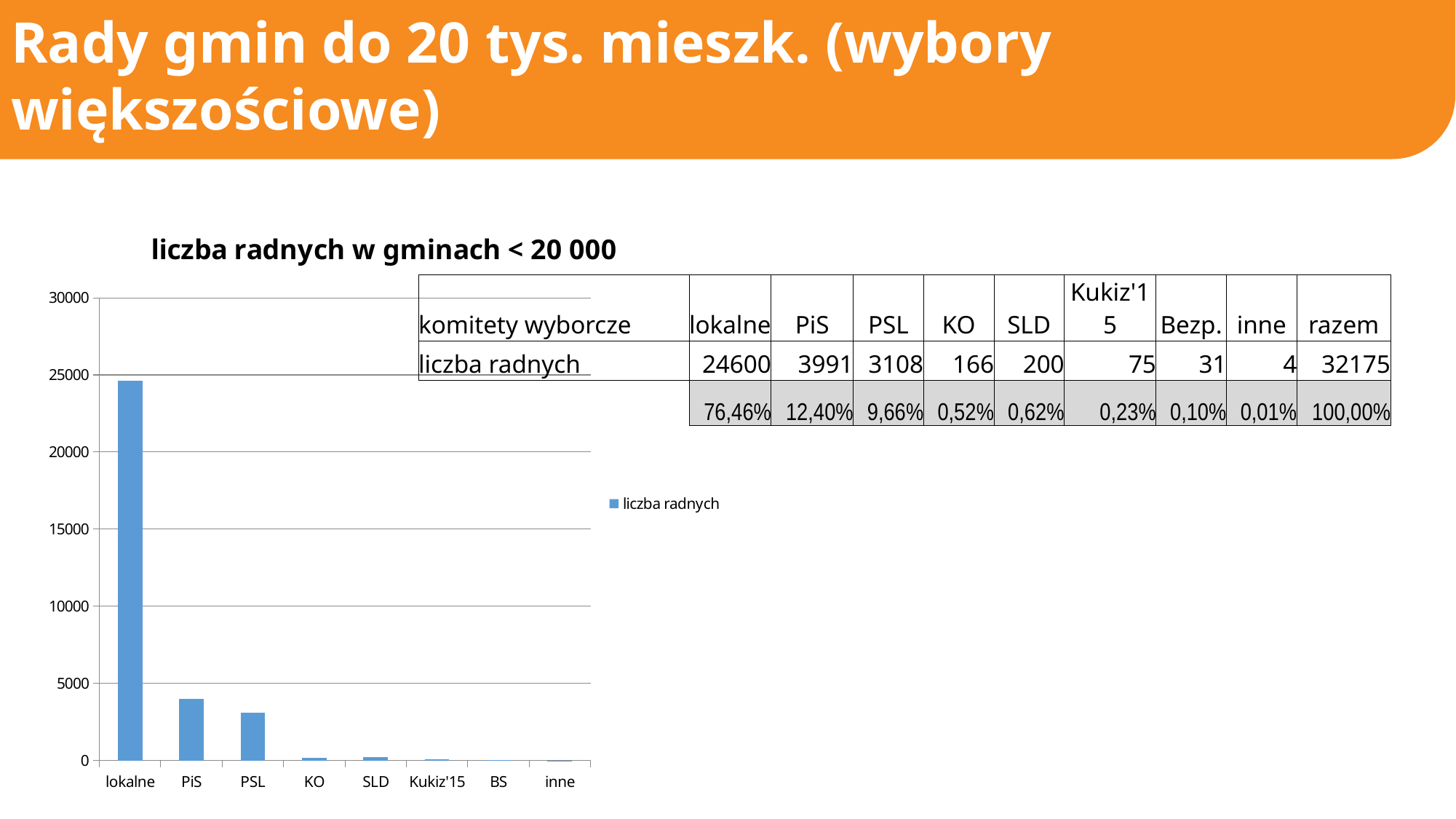
What is the value for lokalne? 24600 What is the title of the chart? liczba radnych w gminach < 20 000 Is the value for lokalne greater or less than 20000? greater What is the value for PSL? 3108 What type of chart is shown on the slide? bar chart Which is larger, the value for PiS or the value for PSL? PiS Which category has the highest value in the chart? lokalne What is the difference between the values for PiS and PSL? 883 Which category has the lowest value in the chart? inne What is the value for PiS? 3991 How many categories are shown on the x axis of the chart? 8 How many series does the chart legend list? 1